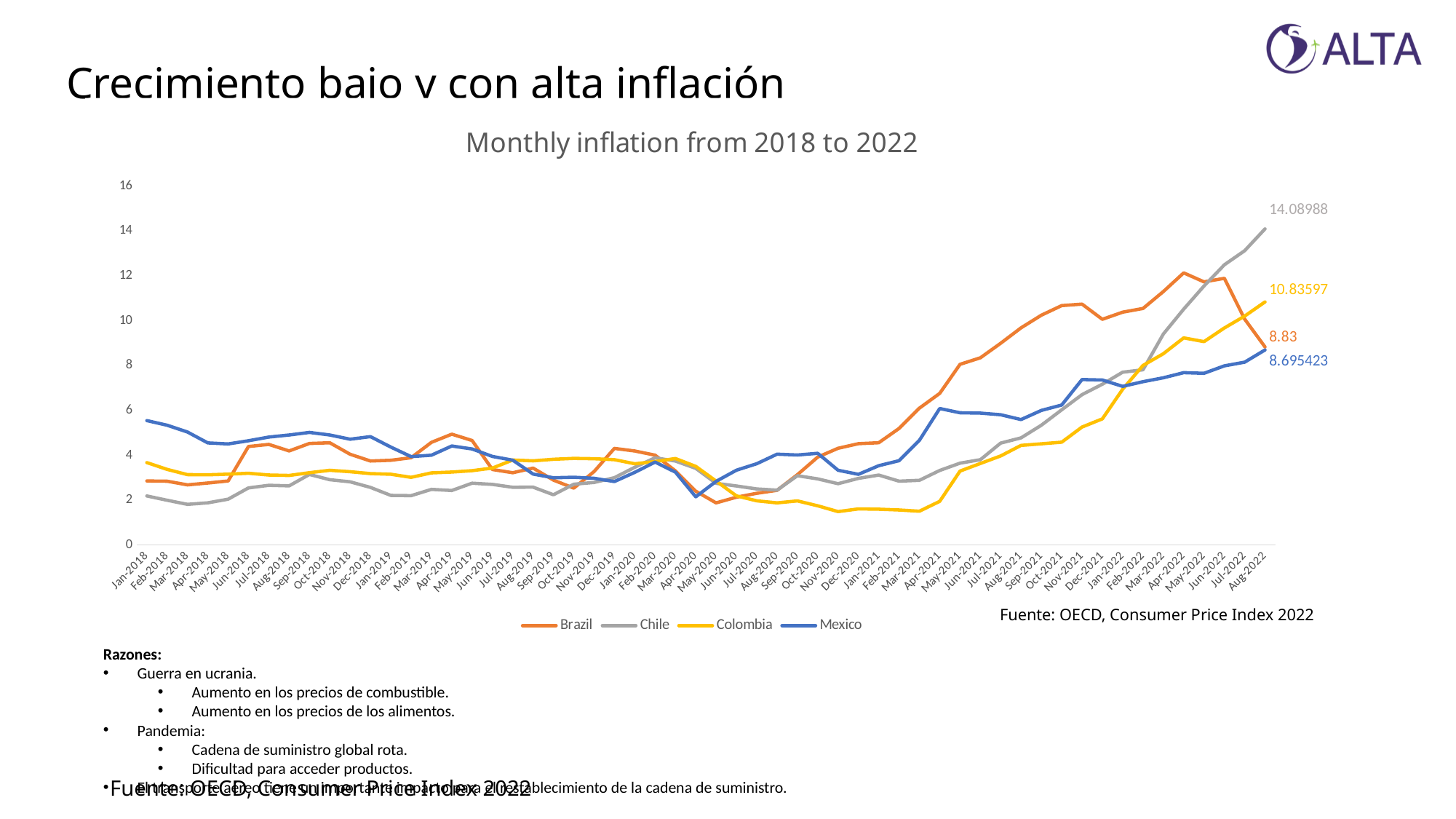
What is the value for Mexico at Aug-2022? 8.695423 Is the value for Colombia at Dec-2020 greater or less than 2? less Which country has the highest inflation value at Aug-2022? Chile What is the value for Chile at Aug-2022? 14.08988 What type of chart is shown on the slide? Line chart What is the value for Brazil at Aug-2022? 8.83 What is the difference between Chile's and Colombia's values at Aug-2022? 3.25391 How many series does the chart legend list? 4 Which country has the lowest inflation value at Aug-2022? Mexico What is the value for Colombia at Aug-2022? 10.83597 Is the value for Mexico at Jan-2018 greater or less than 4? greater What is the title of the chart? Monthly inflation from 2018 to 2022